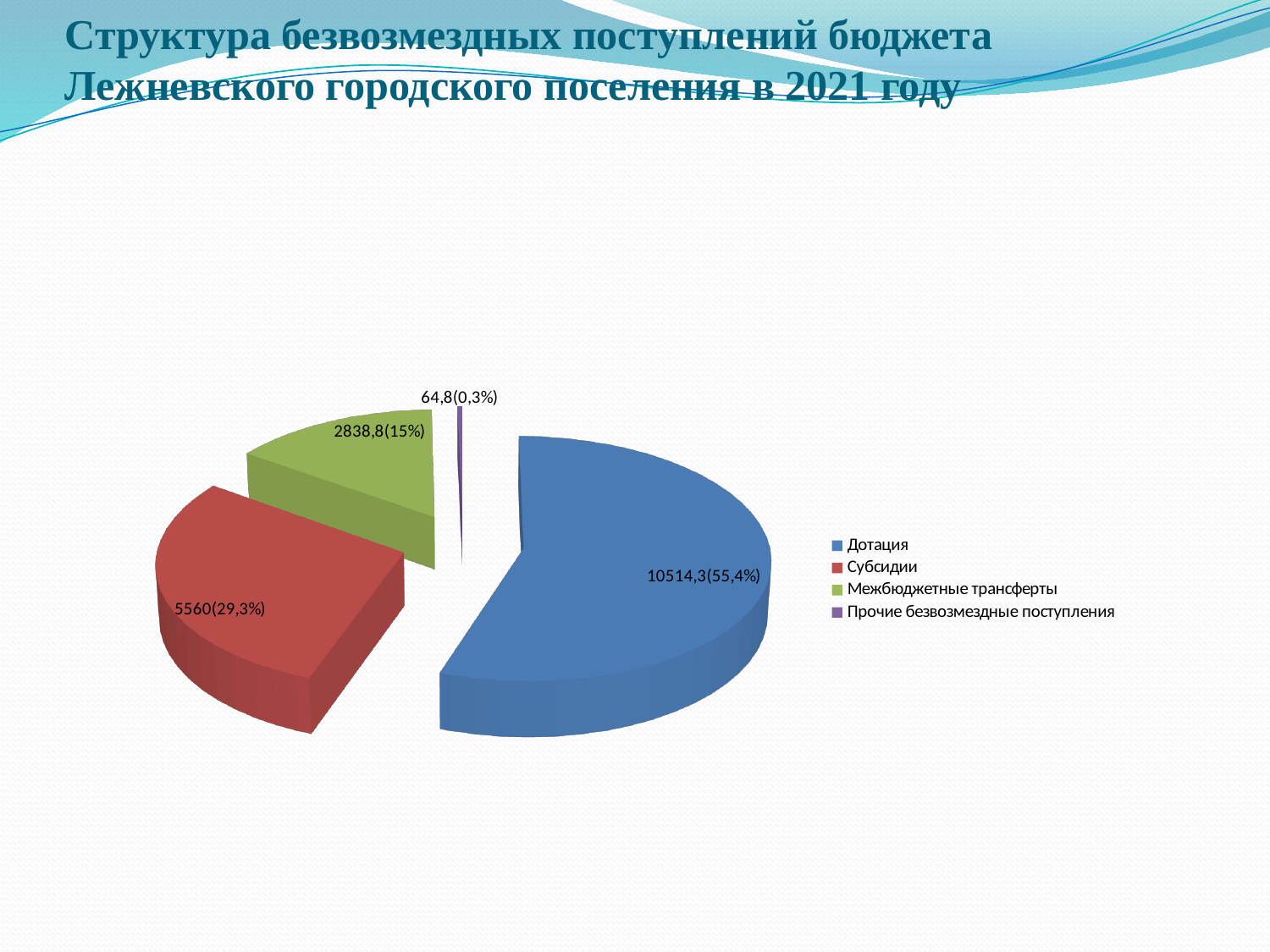
How many slices does the pie chart have? 4 What kind of chart is shown on the slide? Pie chart What value is shown for Субсидии? 5560 What share of the pie does Дотация represent? 55,4% What value is shown for Межбюджетные трансферты? 2838,8 Which category has the smallest slice? Прочие безвозмездные поступления What share of the pie does Субсидии represent? 29,3% What is the difference between the values for Дотация and Субсидии? 4954,3 What value is shown for Прочие безвозмездные поступления? 64,8 How many entries does the legend list? 4 What value is shown for Дотация? 10514,3 Which category has the largest slice? Дотация